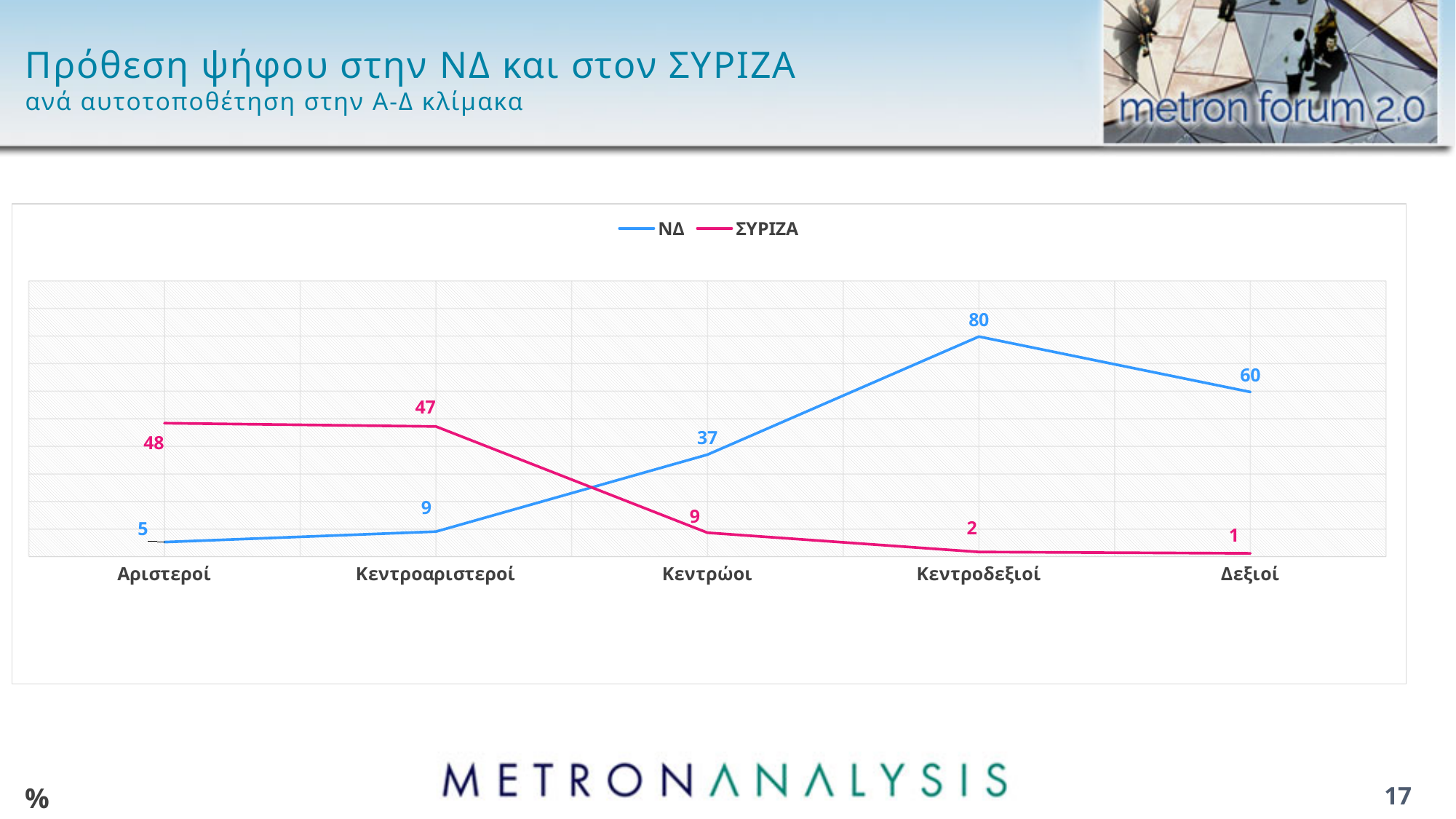
What is the value for ΣΥΡΙΖΑ among Δεξιοί? 1 Does the ΣΥΡΙΖΑ line rise or fall from Κεντροαριστεροί to Δεξιοί? fall In which category does ΝΔ reach its highest value? Κεντροδεξιοί Among Κεντροαριστεροί, which series has the larger value, ΝΔ or ΣΥΡΙΖΑ? ΣΥΡΙΖΑ In which category does ΣΥΡΙΖΑ have its lowest value? Δεξιοί How many categories are shown on the x axis? 5 What is the value for ΣΥΡΙΖΑ among Αριστεροί? 48 What kind of chart is shown on the slide? line chart What is the difference between the ΝΔ and ΣΥΡΙΖΑ values among Κεντροδεξιοί? 78 How many series does the legend list? 2 What is the value for ΝΔ among Κεντρώοι? 37 What is the value for ΝΔ among Κεντροδεξιοί? 80